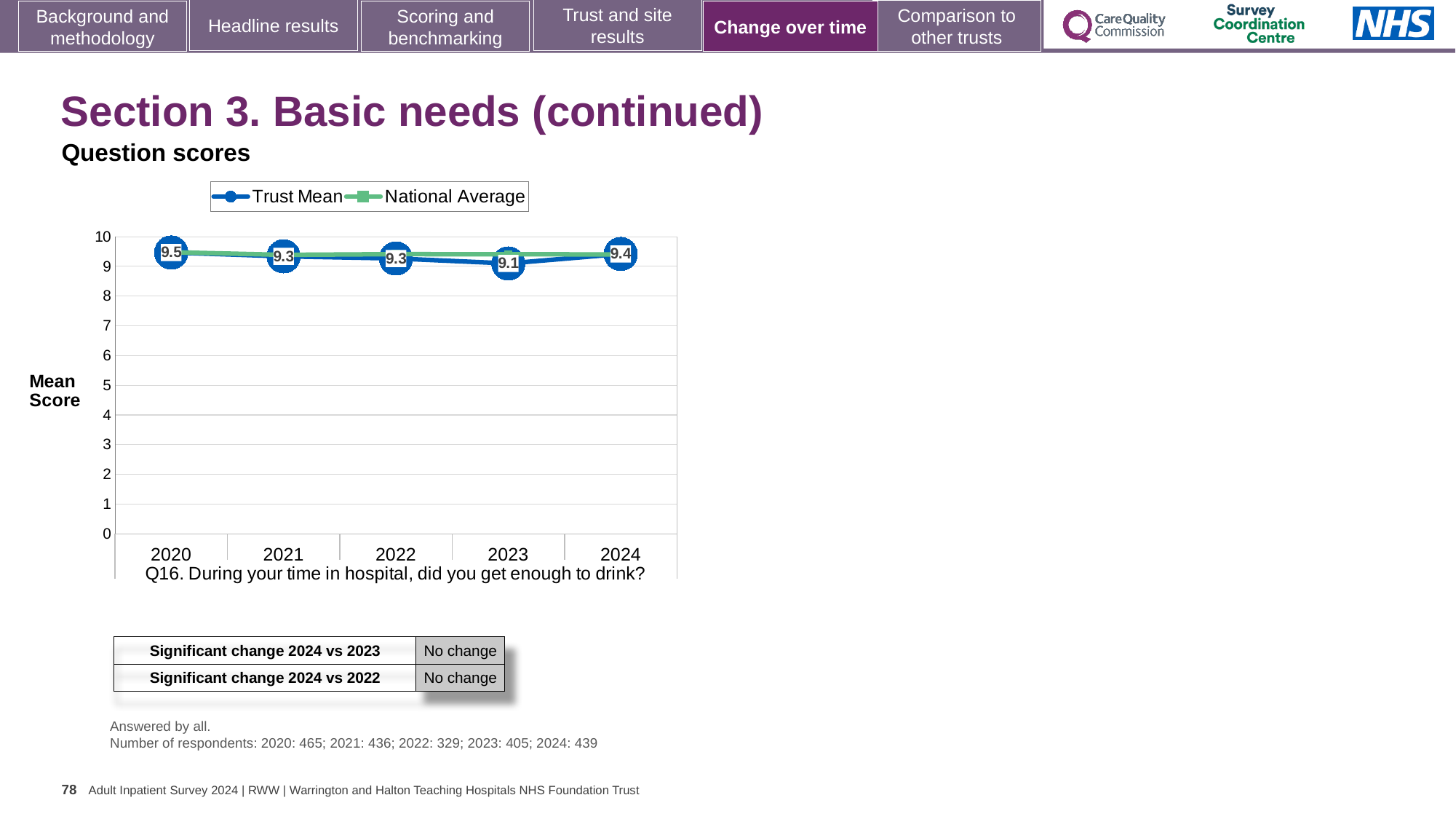
What is the Trust Mean score for 2023? 9.1 Is the Trust Mean score higher in 2024 or in 2023? 2024 What is the Trust Mean score for 2020? 9.5 What is the Trust Mean score for 2021? 9.3 Is the National Average for 2022 greater or less than 8? greater In which year is the Trust Mean score lowest? 2023 What is the difference between the Trust Mean score in 2020 and in 2023? 0.4 What type of chart is shown on the slide? Line chart What is the Trust Mean score for 2024? 9.4 How many years are shown on the x axis of the chart? 5 In which year is the Trust Mean score highest? 2020 How many series does the chart legend list? 2